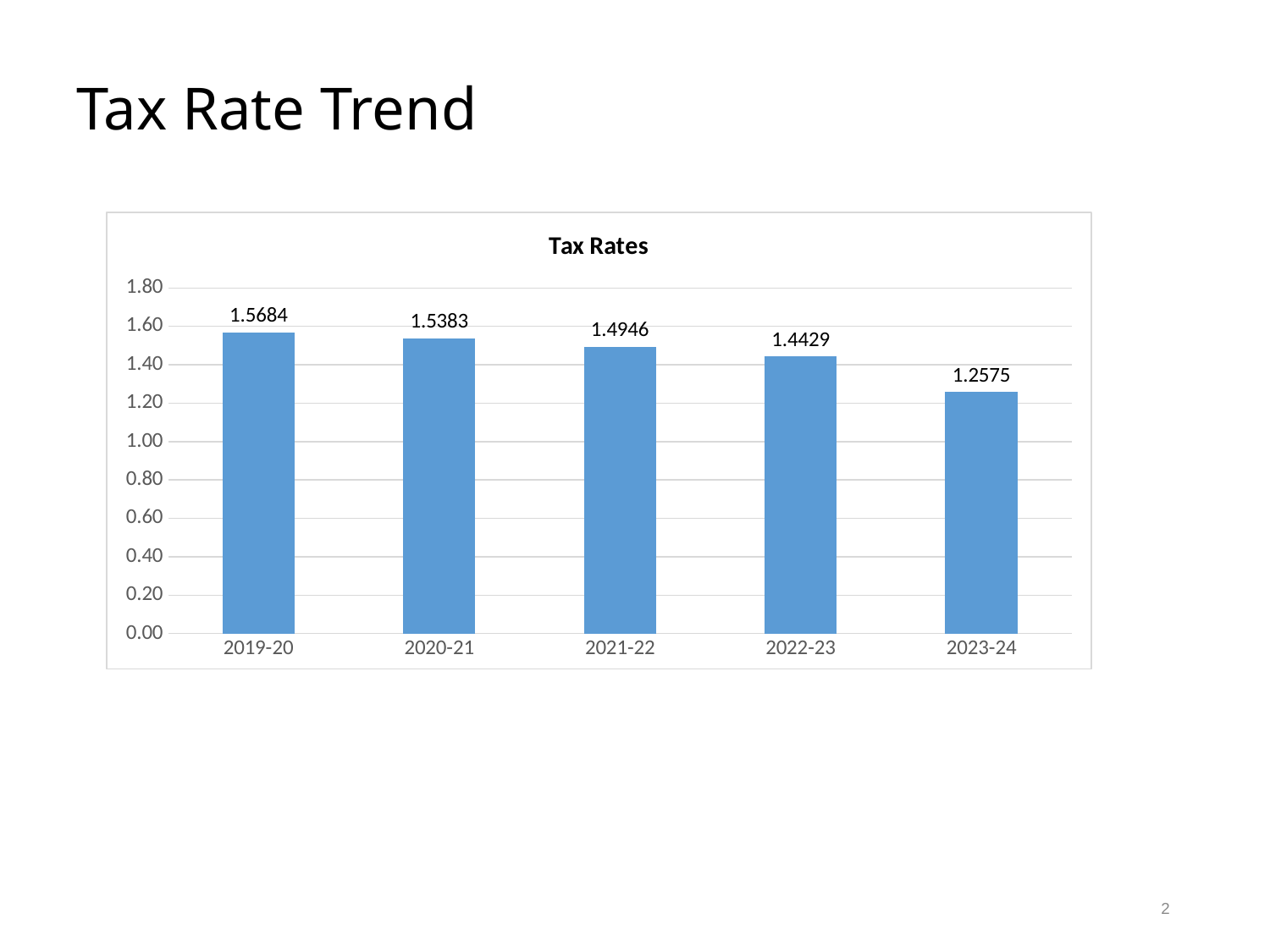
Is the tax rate for 2023-24 greater or less than 1.40? less What is the tax rate for 2021-22? 1.4946 What is the difference between the tax rates for 2022-23 and 2023-24? 0.1854 What is the tax rate for 2023-24? 1.2575 What is the difference between the tax rates for 2019-20 and 2023-24? 0.3109 How many years are shown in the chart? 5 Which is larger, the tax rate for 2020-21 or for 2022-23? 2020-21 Which year has the highest tax rate? 2019-20 Which year has the lowest tax rate? 2023-24 What is the tax rate for 2019-20? 1.5684 Do the tax rates rise or fall from 2019-20 to 2023-24? fall What kind of chart is shown on the slide? bar chart